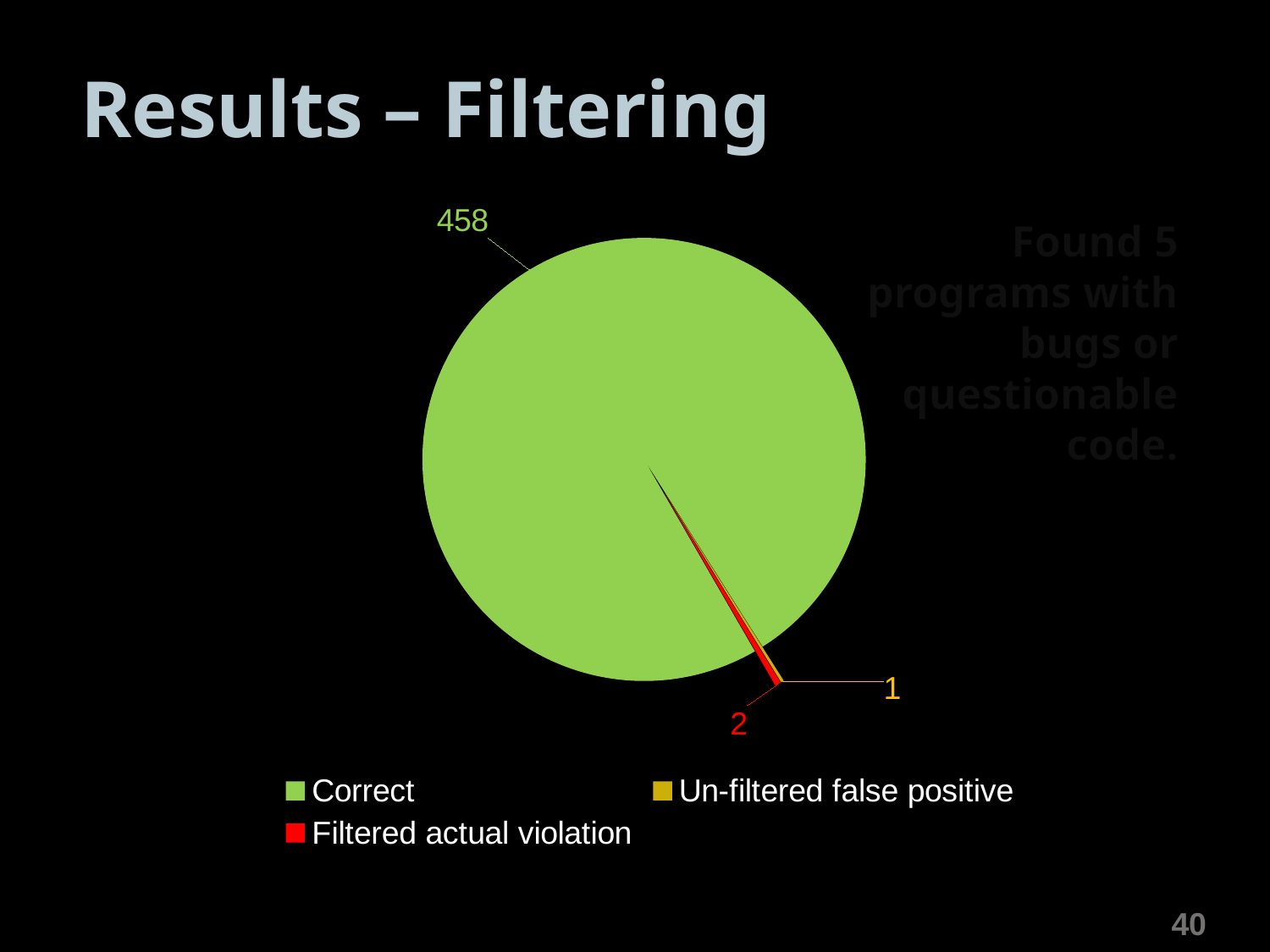
What value is shown for the Correct slice of the pie chart? 458 Which category has the smallest slice of the pie chart? Un-filtered false positive What value is shown for the Un-filtered false positive slice? 1 How many entries does the legend list? 3 What value is shown for the Filtered actual violation slice? 2 Which category has the largest slice of the pie chart? Correct What kind of chart is shown on the slide? Pie chart What colour represents the Filtered actual violation category in the pie chart? Red What is the difference between the Correct value and the Filtered actual violation value? 456 What is the total of all the values in the pie chart? 461 How many categories does the pie chart show? 3 Which is larger, Filtered actual violation or Un-filtered false positive? Filtered actual violation